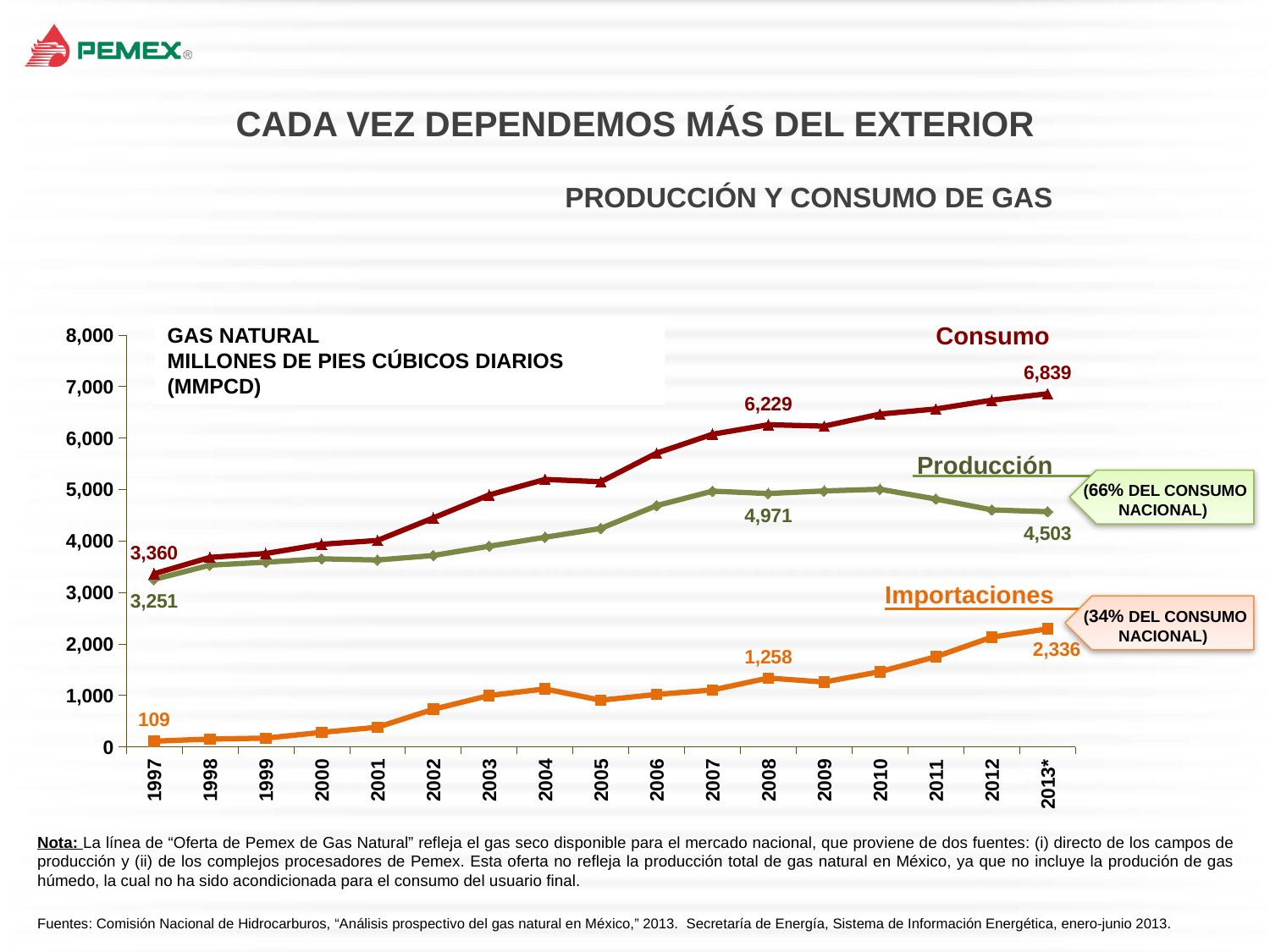
What is the difference between Consumo and Producción in 2013*? 2,336 What type of chart is shown on the slide? line chart Is the Producción value for 2010 greater or less than 4,000? greater How many years are shown on the x axis? 17 What is the Importaciones value for 1997? 109 What is the Producción value for 2013*? 4,503 Which is larger in 2008, Consumo or Importaciones? Consumo Do the Importaciones values generally rise or fall from 1997 to 2013*? rise What is the difference between the Consumo values for 2013* and 1997? 3,479 How many series are plotted on the chart? 3 What is the Consumo value for 2013*? 6,839